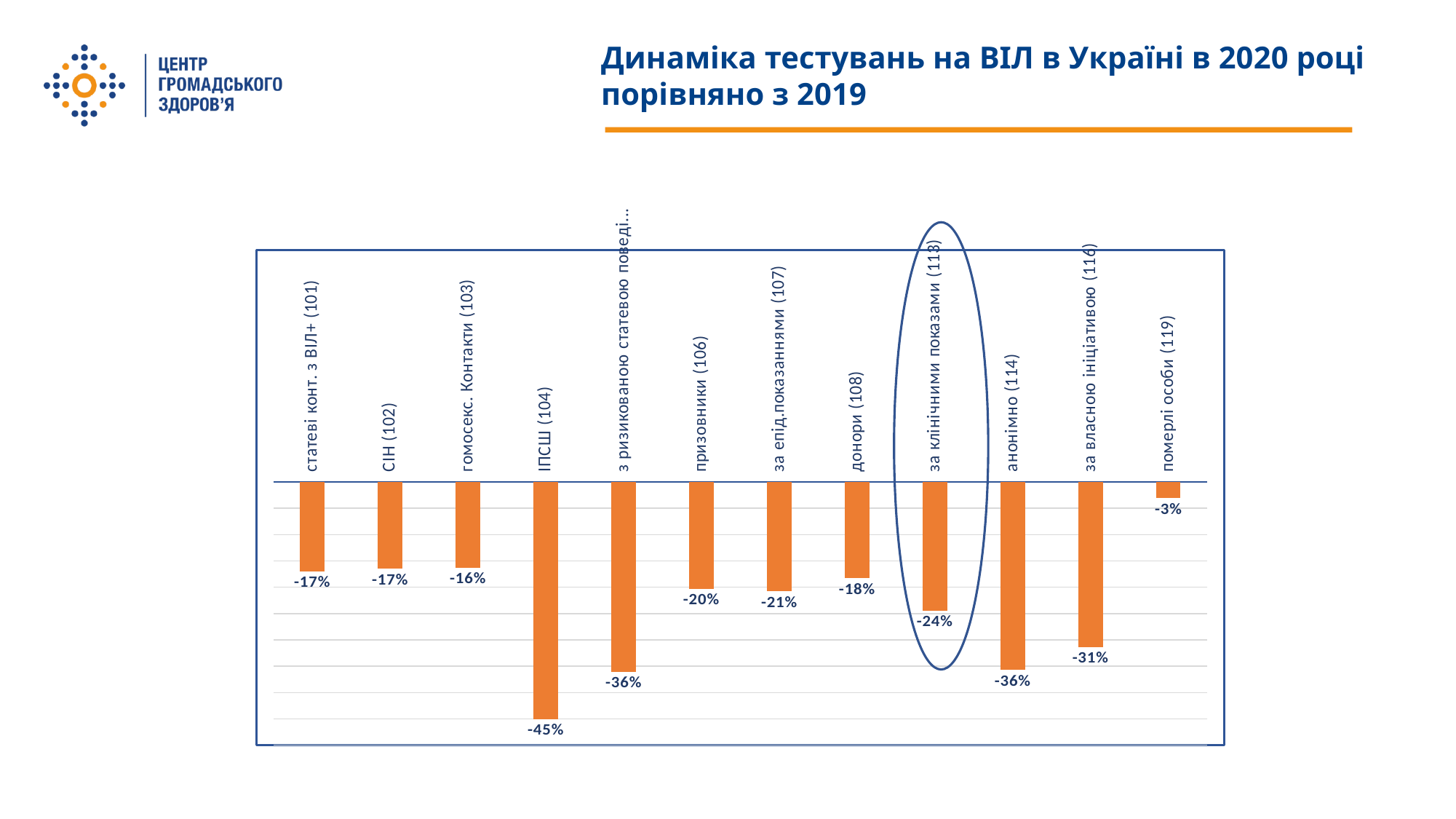
What is the value shown for за власною ініціативою (116)? -31% Which category shows the largest decrease (the lowest value)? ІПСШ (104) What is the difference in percentage points between the values for ІПСШ (104) and померлі особи (119)? 42 percentage points Which category shows the smallest decrease (the highest value)? померлі особи (119) Which category on the chart is highlighted with an oval outline? за клінічними показами (113) What is the value shown for ІПСШ (104)? -45% What is the value shown for померлі особи (119)? -3% What kind of chart is shown on the slide? Bar chart What is the value shown for за клінічними показами (113)? -24% How many categories are plotted in the chart? 12 What is the value shown for донори (108)? -18% Which category shows a larger decrease: призовники (106) or донори (108)? призовники (106)